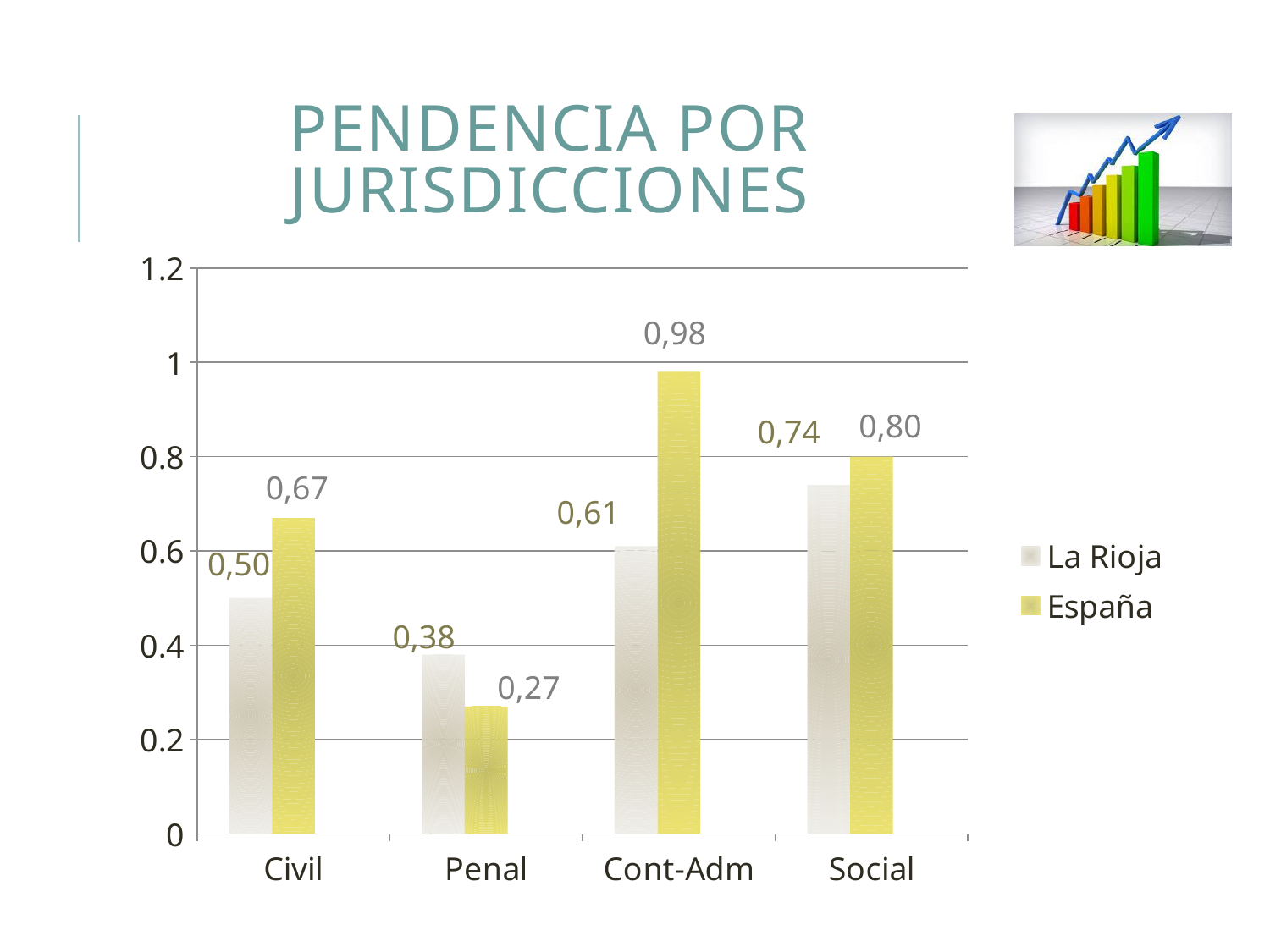
What is the value for España in the Social category? 0,80 What is the value for La Rioja in the Penal category? 0,38 What is the value for La Rioja in the Civil category? 0,50 Which category has the highest value for España? Cont-Adm Which is larger in the Penal category, La Rioja or España? La Rioja What kind of chart is shown on the slide? Bar chart How many series does the legend list? 2 What is the difference between the España and La Rioja values in the Cont-Adm category? 0,37 How many categories are shown on the x axis? 4 What is the title of the slide? PENDENCIA POR JURISDICCIONES Which category has the lowest value for La Rioja? Penal What is the value for España in the Cont-Adm category? 0,98